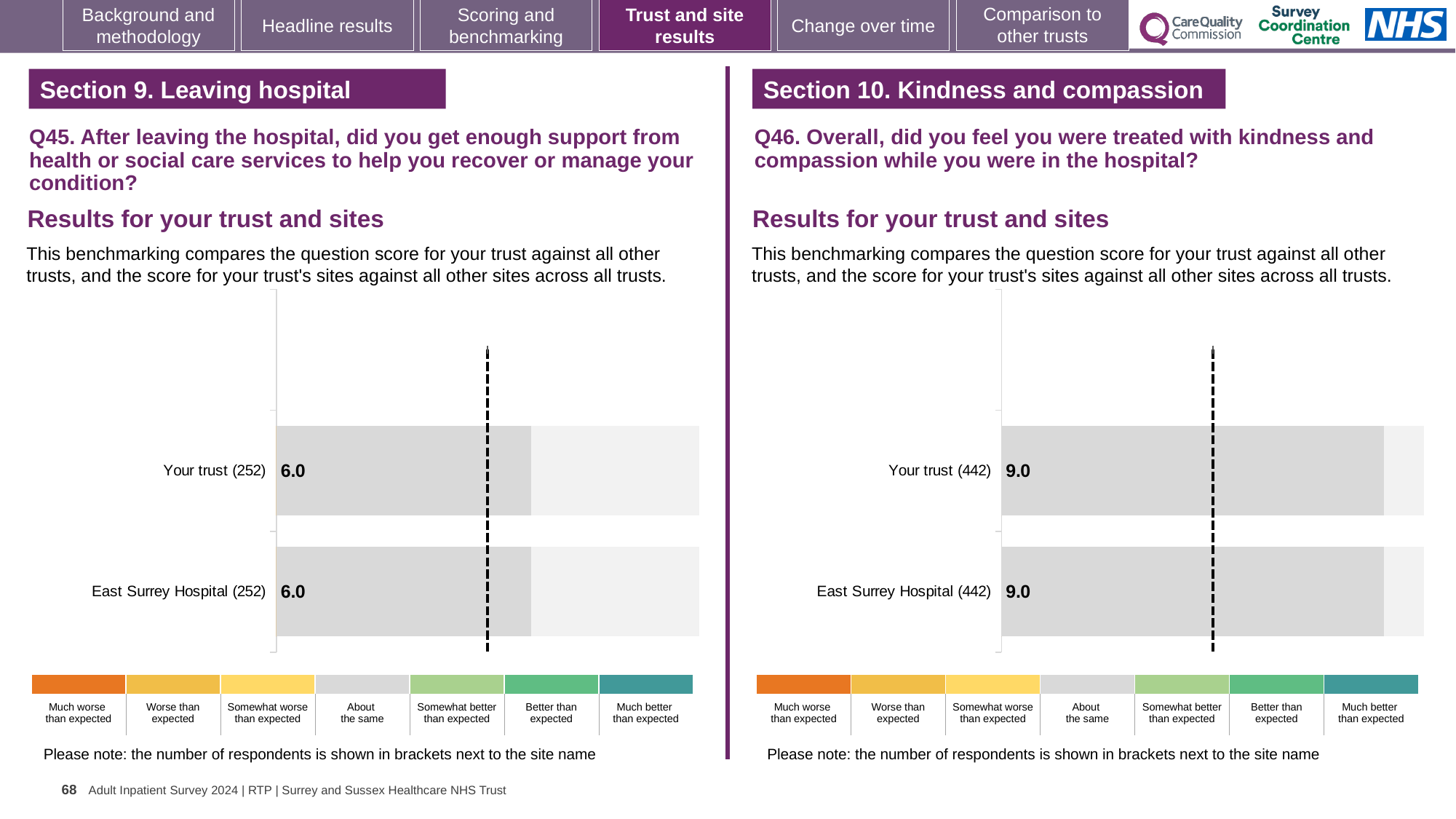
What is the difference between the Your trust score on the Q46 chart (right) and the Your trust score on the Q45 chart (left)? 3.0 Which is larger: the Your trust score on the Q45 chart (left) or the Your trust score on the Q46 chart (right)? Q46 chart (right) On the Q46 chart (right), what is the score for Your trust? 9.0 On the Q45 chart (left), how many respondents are shown in brackets for East Surrey Hospital? 252 How many categories does the colour key below the Q45 chart (left) list? 7 On the Q45 chart (left), what is the score for East Surrey Hospital? 6.0 On the Q46 chart (right), how many respondents are shown in brackets for Your trust? 442 On the Q45 chart (left), how many bars are plotted? 2 On the Q46 chart (right), how many bars are plotted? 2 On the Q46 chart (right), what is the score for East Surrey Hospital? 9.0 On the Q45 chart (left), what is the score for Your trust? 6.0 What kind of chart is used on the Q46 chart (right)? Bar chart